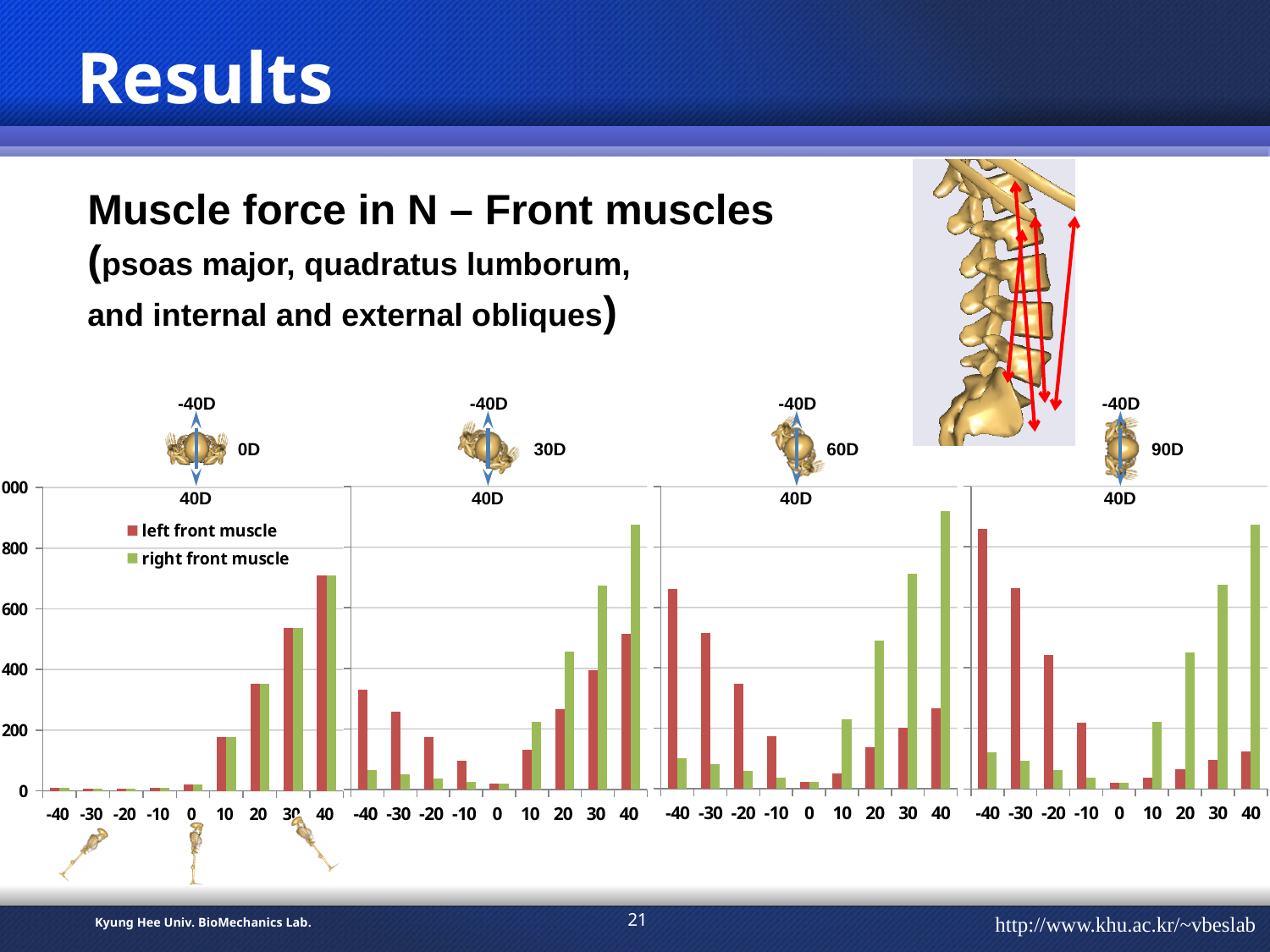
In the 90D chart, is the left front muscle value at -40 greater or less than 800? greater In the 0D chart, do the right front muscle values rise or fall from -40 to 40? rise In the 30D chart, is the left front muscle value at -40 greater or less than 400? less What kind of chart is used for the 0D panel? bar chart In the 30D chart, how many categories are shown on the x axis? 9 What colour represents the right front muscle in the legend? green How many series does the legend list? 2 In the 60D chart, is the right front muscle value at 40 greater or less than 800? greater In the 90D chart, at category -40, which is larger: the left front muscle or the right front muscle? left front muscle In the 0D chart, which category has the highest left front muscle value? 40 In the 90D chart, do the left front muscle values generally rise or fall from -40 to 40? fall In the 60D chart, at category 40, which is larger: the left front muscle or the right front muscle? right front muscle